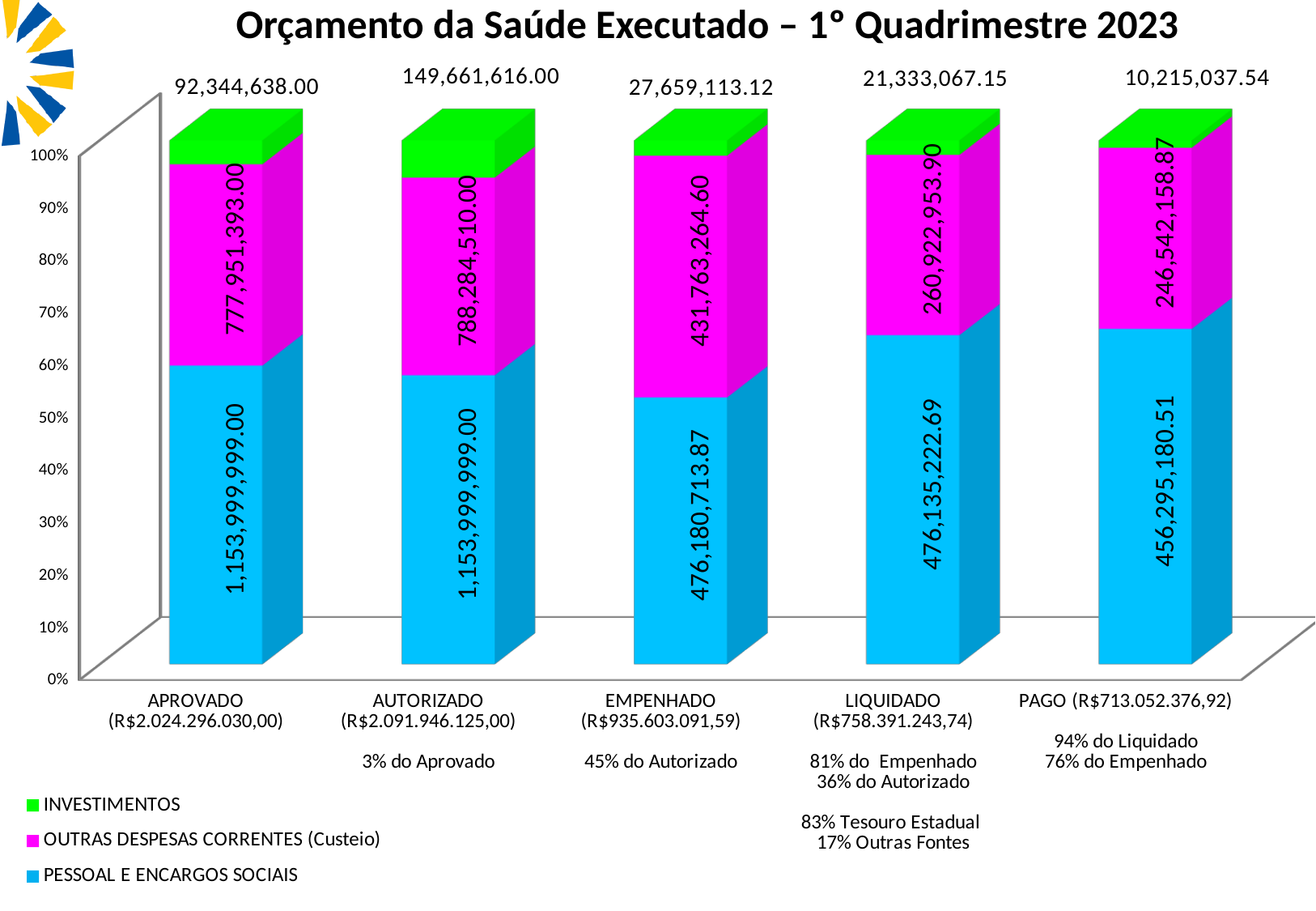
What total amount is printed under the LIQUIDADO category label? R$758.391.243,74 How many series does the legend list? 3 What is the value of INVESTIMENTOS for the EMPENHADO bar? 27,659,113.12 How many categories are shown on the x axis? 5 Which category has the highest INVESTIMENTOS value? AUTORIZADO Which is larger: OUTRAS DESPESAS CORRENTES (Custeio) for LIQUIDADO or for PAGO? LIQUIDADO What is the value of OUTRAS DESPESAS CORRENTES (Custeio) for the PAGO bar? 246,542,158.87 What is the difference between the INVESTIMENTOS values for AUTORIZADO and APROVADO? 57,316,978.00 What kind of chart is shown on the slide? Stacked bar chart Which category has the lowest INVESTIMENTOS value? PAGO Is the share of PESSOAL E ENCARGOS SOCIAIS in the LIQUIDADO bar greater or less than 60%? greater What is the value of PESSOAL E ENCARGOS SOCIAIS for the APROVADO bar? 1,153,999,999.00